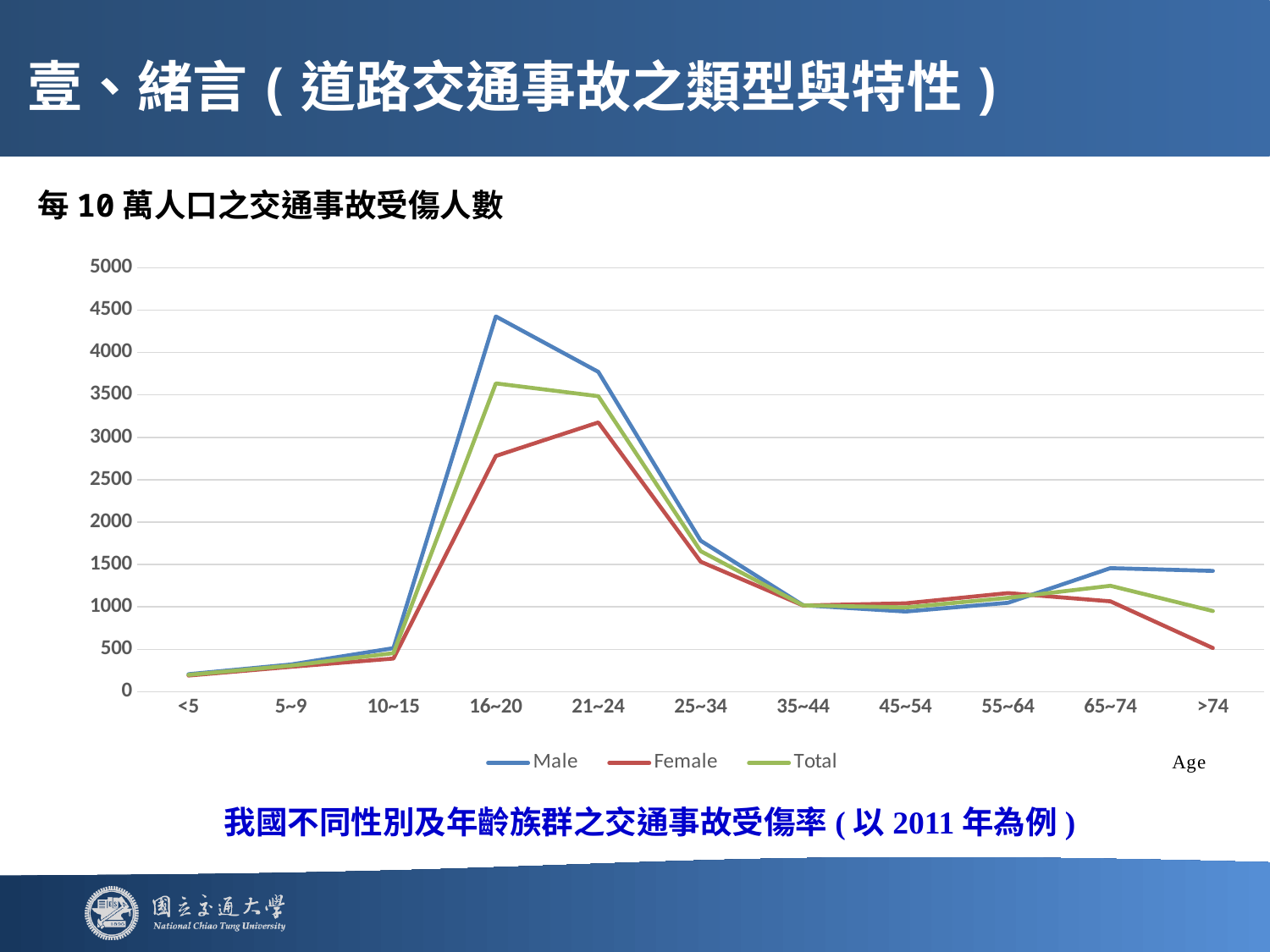
Which age group has the highest value for the Female series? 21~24 How many age groups are shown on the x axis? 11 Which age group has the lowest value for the Total series? <5 How many series does the legend list? 3 What kind of chart is shown on the slide? line chart Is the Male value for the 16~20 age group greater or less than 4000? greater What are the three series named in the legend? Male, Female, Total Which is larger for the 16~20 age group, the Male value or the Female value? Male Do the Male values rise or fall from the 16~20 age group to the 35~44 age group? fall Is the Male value for the 25~34 age group greater or less than 1500? greater Is the Female value for the 16~20 age group greater or less than 3000? less Which age group has the highest value for the Male series? 16~20